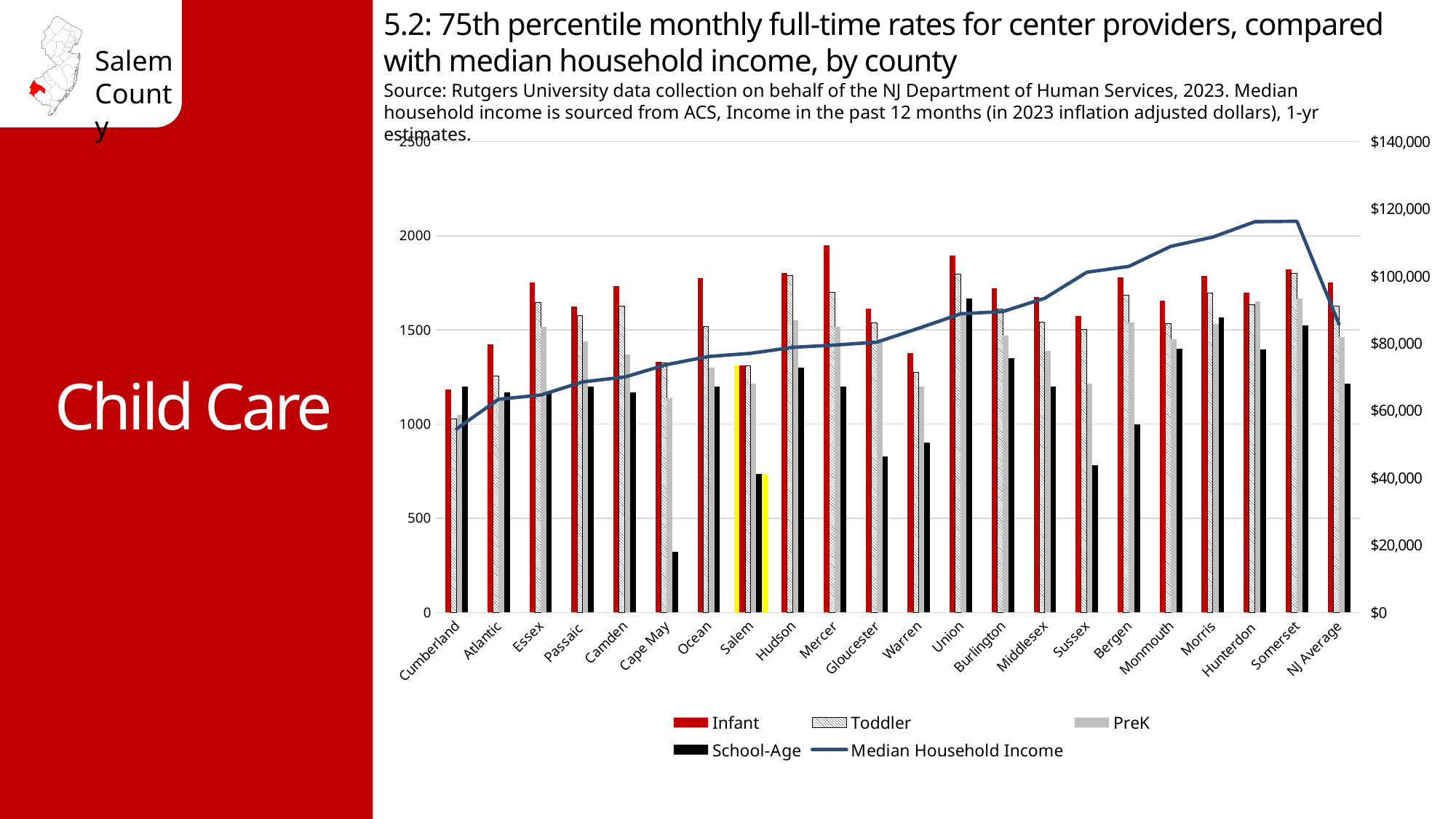
How many counties/categories are shown on the x axis of the chart? 22 Which is larger, the Infant rate for Mercer or the Infant rate for Cumberland? Mercer Which county has the lowest Infant rate? Cumberland Is the Infant rate for Salem greater or less than 1000? greater What kind of chart is shown on the slide? Bar chart with a line Does the Median Household Income line generally rise or fall from Cumberland to Somerset? rise Which county has the highest Infant rate? Mercer How many series does the chart's legend list? 5 Is the Median Household Income for Somerset greater or less than $100,000? greater Is the School-Age rate for Salem greater or less than 1000? less Which county has the lowest Median Household Income? Cumberland Which county has the lowest School-Age rate? Cape May